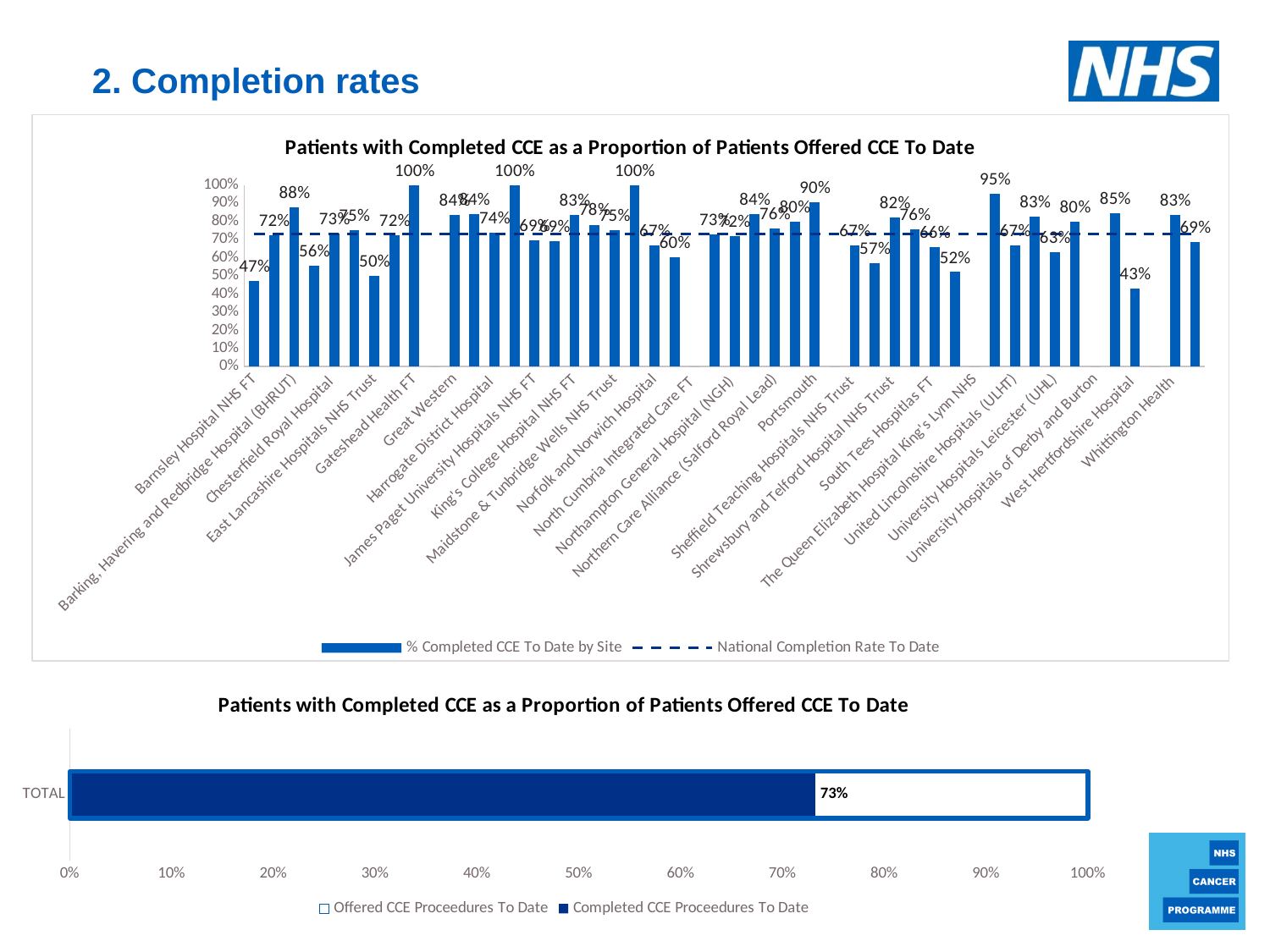
In the top chart, what is the lowest value labelled on any bar? 43% What kind of chart is the bottom chart showing the TOTAL row? bar chart In the top chart, what is the highest value labelled on any bar? 100% In the top chart, what does the dashed horizontal line represent according to the legend? National Completion Rate To Date In the bottom chart, what is the Completed CCE Proceedures To Date value for TOTAL? 73% What kind of chart is the top chart? combination bar and line chart How many entries does the legend of the top chart list? 2 In the top chart, how many bars are labelled 100%? 3 In the top chart, what is the difference between the highest labelled bar value (100%) and the lowest labelled bar value (43%)? 57% In the top chart, is the value of the leftmost bar greater or less than 50%? less In the bottom chart, is the Completed CCE Proceedures To Date value for TOTAL greater or less than 70%? greater How many series does the legend of the bottom chart list? 2